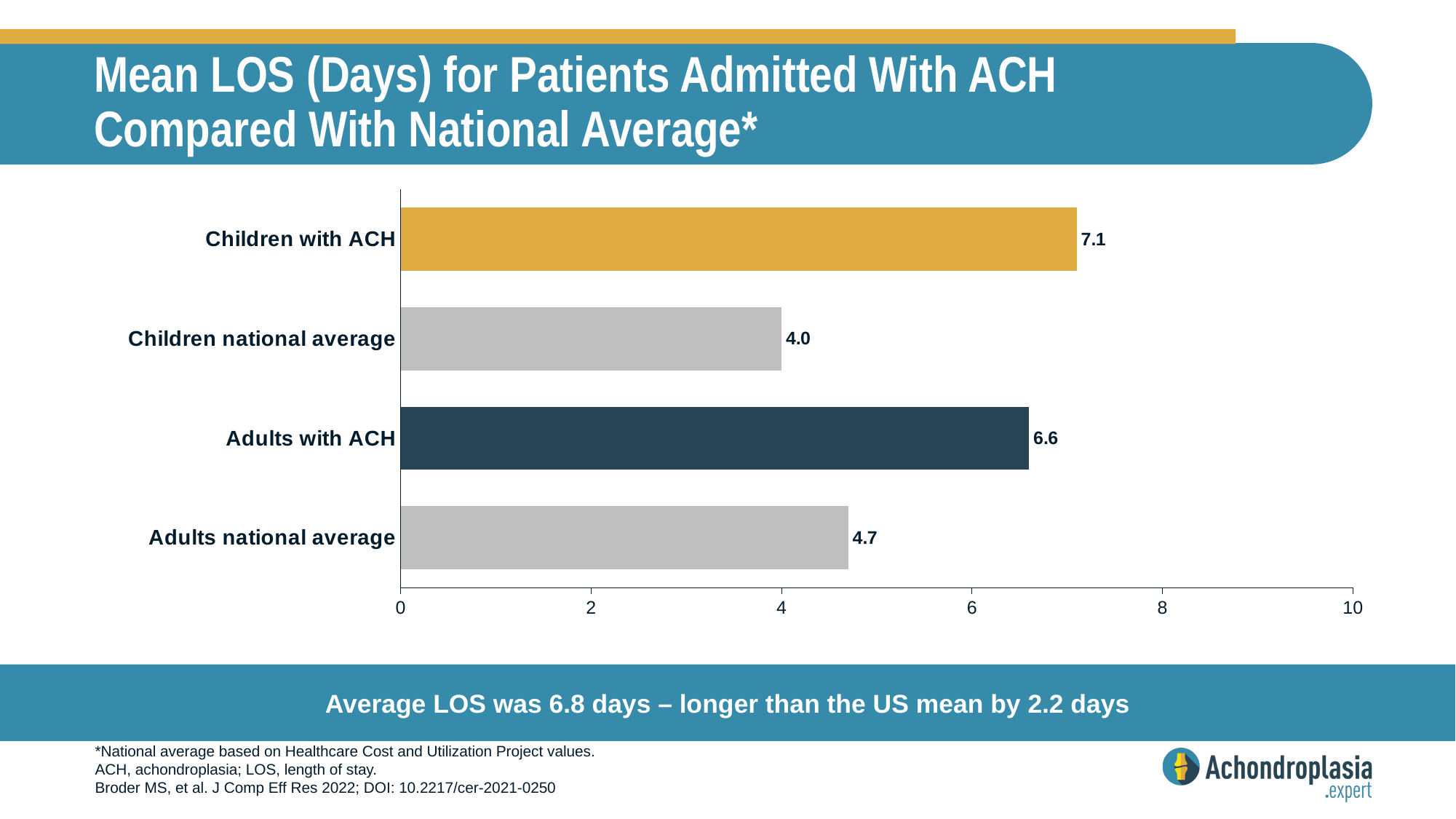
What is the difference in mean LOS between Adults with ACH and the Adults national average? 1.9 What is the mean LOS in days for the Children national average? 4.0 What is the mean LOS in days for the Adults national average? 4.7 What is the mean LOS in days for Children with ACH? 7.1 Which category has the highest mean LOS? Children with ACH Which is larger, the mean LOS for Adults with ACH or for Children with ACH? Children with ACH What is the title of the chart? Mean LOS (Days) for Patients Admitted With ACH Compared With National Average* Which category has the lowest mean LOS? Children national average What is the difference in mean LOS between Children with ACH and the Children national average? 3.1 What kind of chart is shown on the slide? Bar chart What is the mean LOS in days for Adults with ACH? 6.6 How many categories are shown in the chart? 4